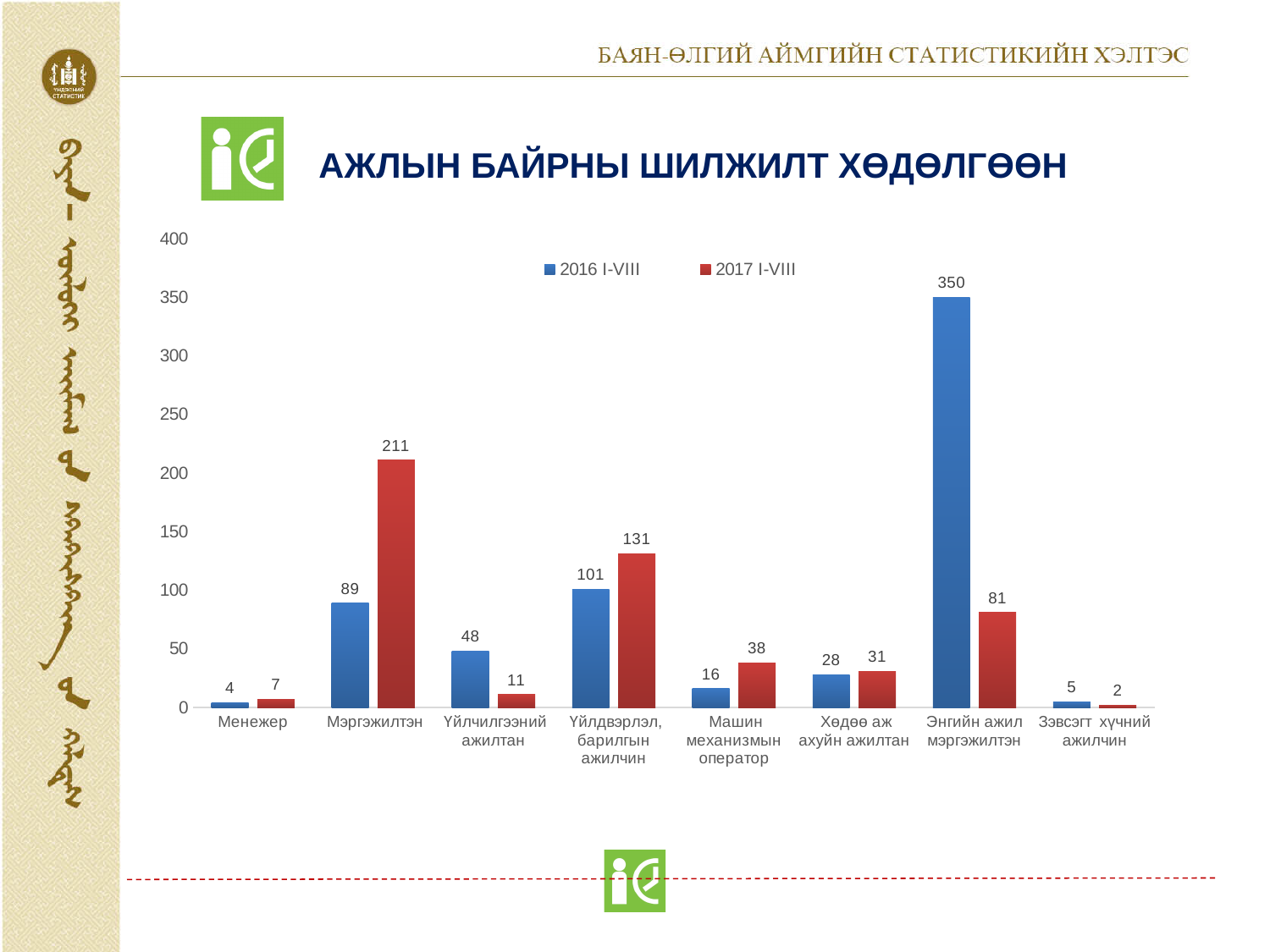
Which category has the lowest value in the 2017 I-VIII series? Зэвсэгт хүчний ажилчин Which category has the highest value in the 2016 I-VIII series? Энгийн ажил мэргэжилтэн For Үйлчилгээний ажилтан, which series has the larger value, 2016 I-VIII or 2017 I-VIII? 2016 I-VIII What is the value for Мэргэжилтэн in the 2017 I-VIII series? 211 What is the title of the chart? АЖЛЫН БАЙРНЫ ШИЛЖИЛТ ХӨДӨЛГӨӨН Is the 2017 I-VIII value for Үйлдвэрлэл, барилгын ажилчин greater or less than 100? greater What is the difference between the 2017 I-VIII and 2016 I-VIII values for Мэргэжилтэн? 122 What is the value for Энгийн ажил мэргэжилтэн in the 2016 I-VIII series? 350 What type of chart is shown on the slide? bar chart How many categories are shown on the x axis? 8 How many series does the legend list? 2 What is the value for Машин механизмын оператор in the 2017 I-VIII series? 38